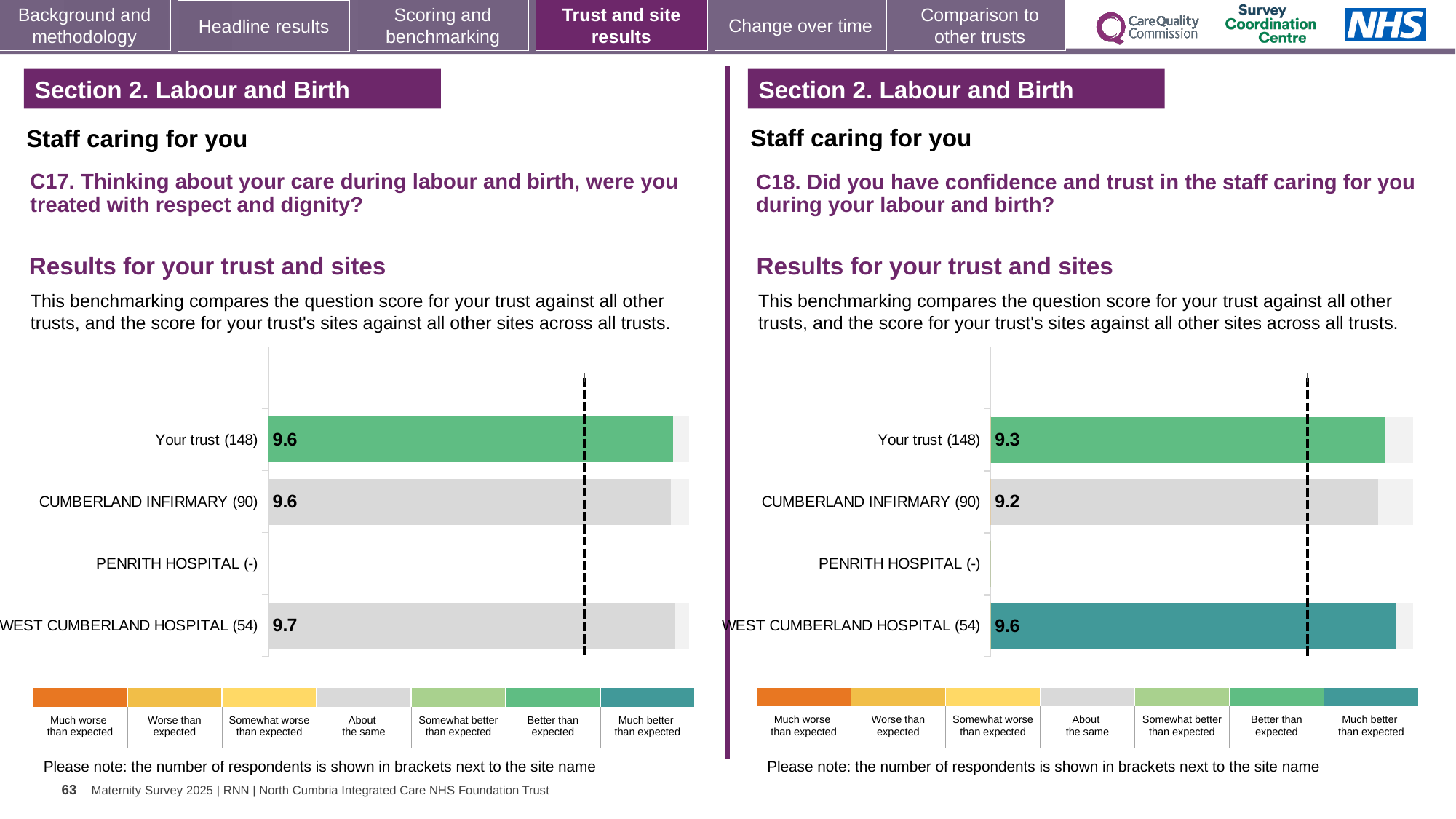
In the C17 chart on the left, what is the score for WEST CUMBERLAND HOSPITAL? 9.7 In the C18 chart on the right, what is the score for Your trust? 9.3 How many site/trust rows are listed in the C18 chart on the right? 4 In the C18 chart on the right, which labelled bar has the lowest score? CUMBERLAND INFIRMARY In the C18 chart on the right, what is the score for CUMBERLAND INFIRMARY? 9.2 What kind of chart is used in the C17 chart on the left? Bar chart In the C17 chart on the left, which is larger: the score for WEST CUMBERLAND HOSPITAL or the score for Your trust? WEST CUMBERLAND HOSPITAL In the C18 chart on the right, what is the difference between the scores for WEST CUMBERLAND HOSPITAL and CUMBERLAND INFIRMARY? 0.4 In the C17 chart on the left, what is the score for Your trust? 9.6 In the C18 chart on the right, which benchmark category does the colour of the WEST CUMBERLAND HOSPITAL bar correspond to in the legend? Much better than expected In the C18 chart on the right, which site has the highest score? WEST CUMBERLAND HOSPITAL In the C17 chart on the left, how many respondents are shown in brackets for CUMBERLAND INFIRMARY? 90